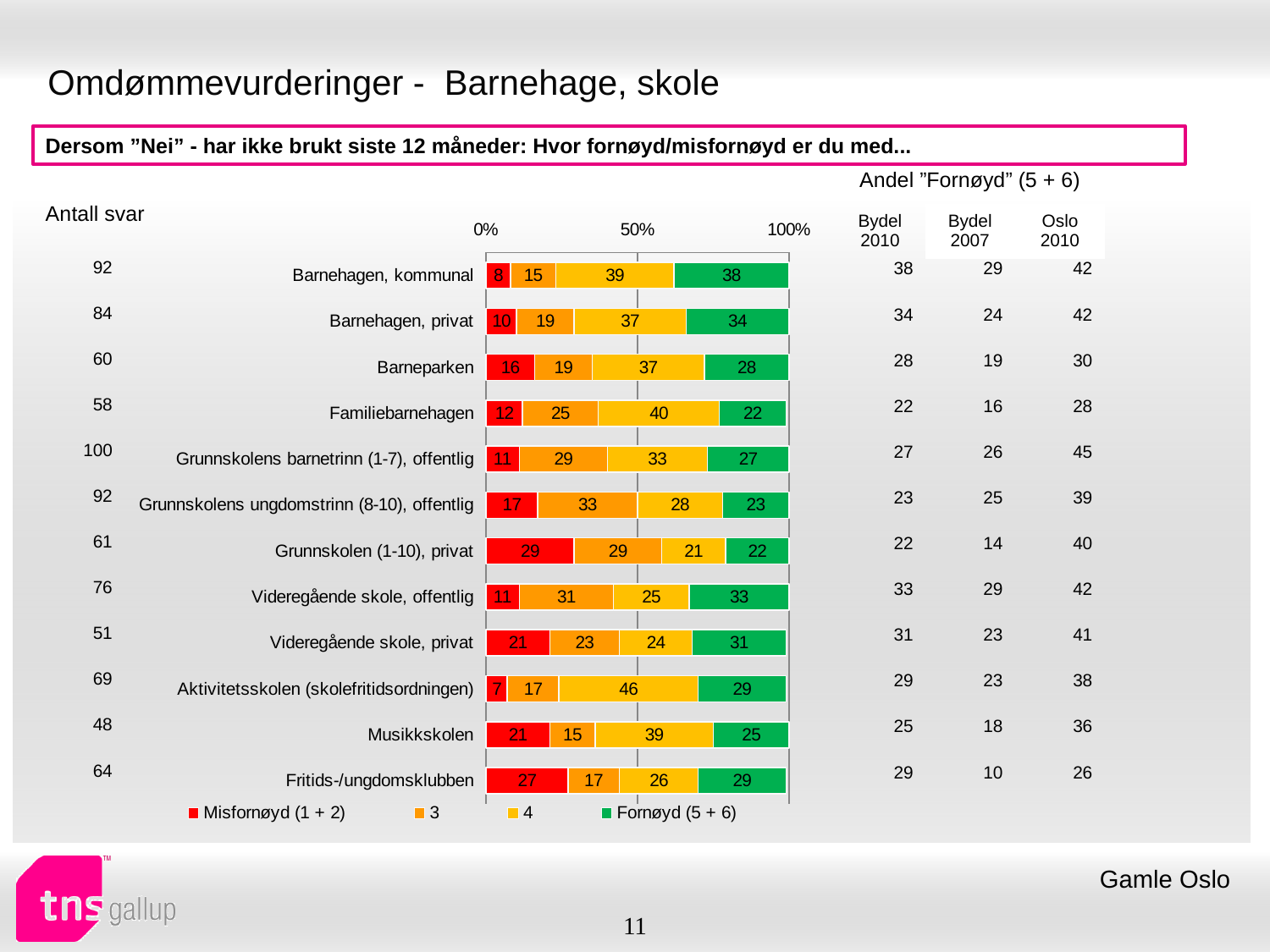
How many categories (rows) are plotted in the chart? 12 What is the difference between the Fornøyd (5 + 6) values for Barnehagen, kommunal and Familiebarnehagen? 16 What kind of chart is shown on the slide? stacked bar chart Which has the larger Misfornøyd (1 + 2) value: Fritids-/ungdomsklubben or Musikkskolen? Fritids-/ungdomsklubben What is the value of series 4 for Aktivitetsskolen (skolefritidsordningen)? 46 What is the total of the stacked bar for Barnehagen, privat? 100 What colour represents the Fornøyd (5 + 6) series in the chart? green Which category has the lowest Misfornøyd (1 + 2) value? Aktivitetsskolen (skolefritidsordningen) How many series does the chart legend list? 4 What is the Fornøyd (5 + 6) value for Barnehagen, kommunal? 38 What is the Misfornøyd (1 + 2) value for Grunnskolen (1-10), privat? 29 Which category has the highest Fornøyd (5 + 6) value? Barnehagen, kommunal